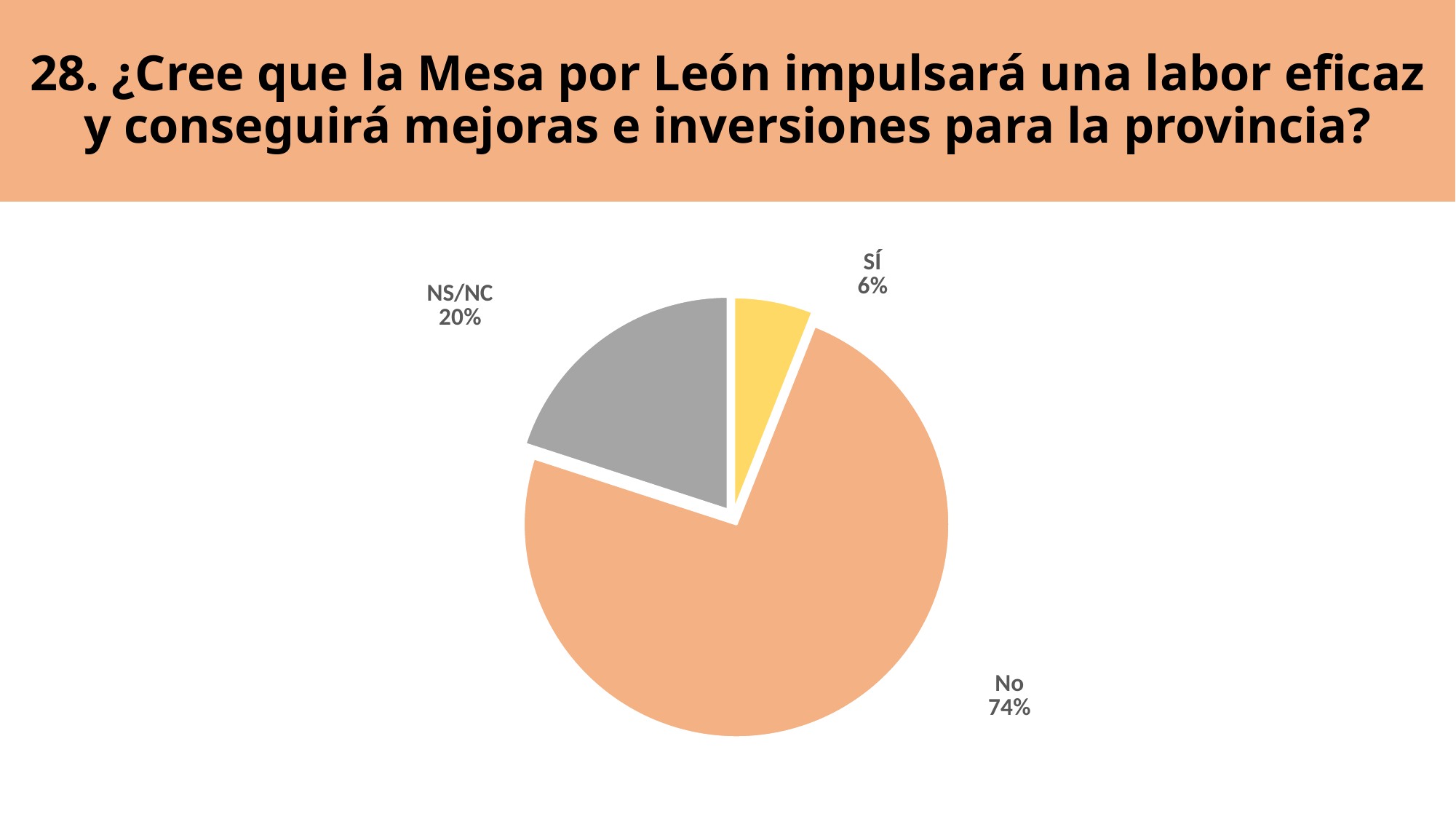
Which is larger, the share for "NS/NC" or the share for "SÍ"? NS/NC What is the difference in percentage points between "NS/NC" and "SÍ"? 14 What percentage of respondents answered "SÍ"? 6% What colour is the "SÍ" slice? Yellow Which response has the largest share of the pie? No What is the difference in percentage points between "No" and "SÍ"? 68 What colour is the "NS/NC" slice? Grey What percentage of respondents answered "NS/NC"? 20% What kind of chart is shown on the slide? Pie chart Which response has the smallest share of the pie? SÍ How many slices does the pie chart have? 3 What percentage of respondents answered "No"? 74%